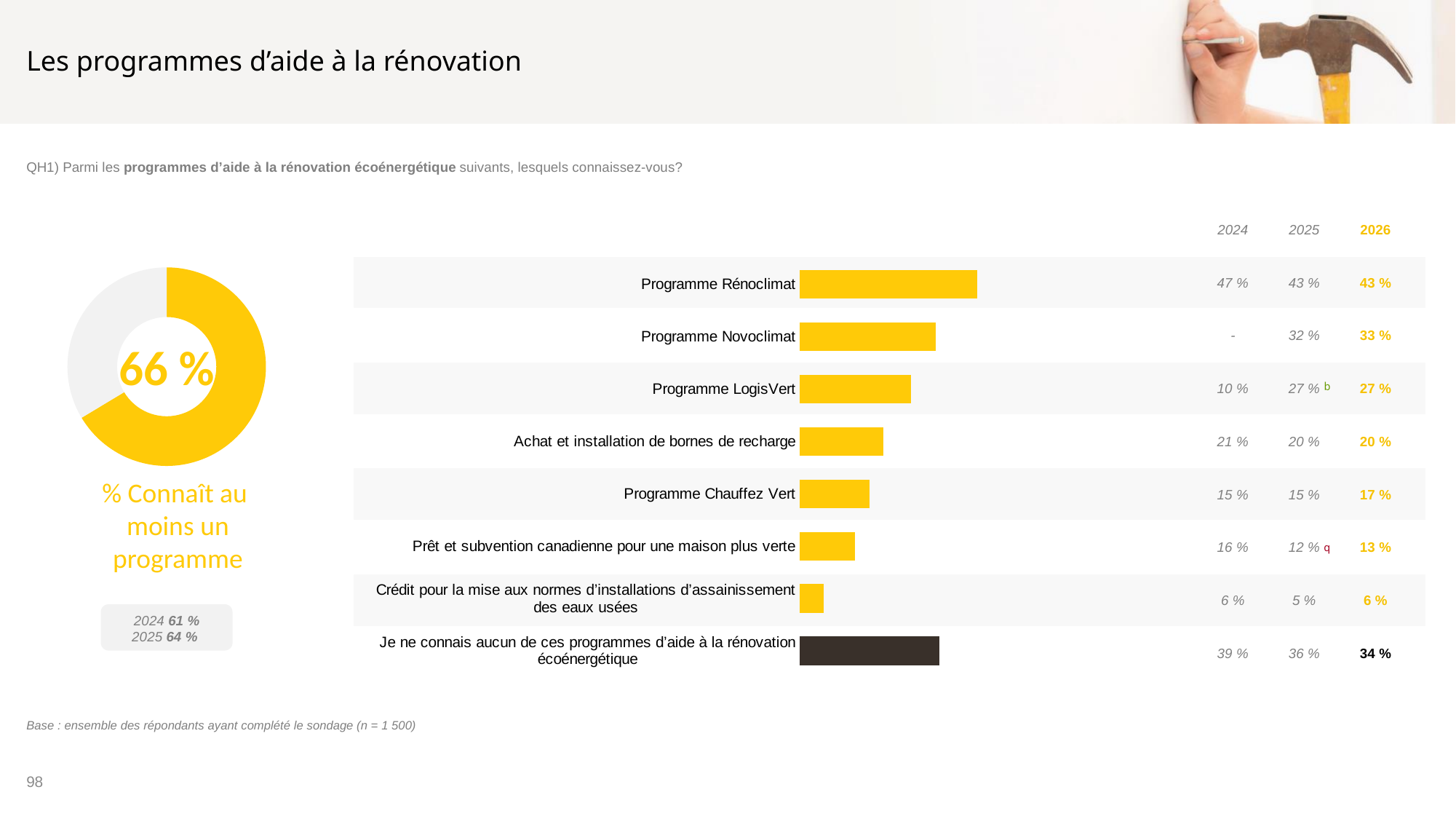
In the bar chart, which has a larger 2026 value: Programme Chauffez Vert or Achat et installation de bornes de recharge? Achat et installation de bornes de recharge How many categories are shown in the bar chart? 8 In the bar chart, what is the 2026 value for Programme Novoclimat? 33 % In the bar chart, which bar is shown in a dark colour rather than yellow? Je ne connais aucun de ces programmes d'aide à la rénovation écoénergétique In the bar chart, what is the 2024 value for Programme LogisVert? 10 % In the bar chart, which programme has the highest 2026 value? Programme Rénoclimat What kind of chart is the chart on the right of the slide? bar chart In the bar chart, what is the 2026 value for the category 'Je ne connais aucun de ces programmes d'aide à la rénovation écoénergétique'? 34 % In the bar chart, what is the difference between the 2026 values for Programme Rénoclimat and Programme Novoclimat? 10 % In the bar chart, which category has the lowest 2026 value? Crédit pour la mise aux normes d'installations d'assainissement des eaux usées In the bar chart, what is the 2026 value for Programme Rénoclimat? 43 % In the donut chart on the left, what percentage of respondents know at least one programme? 66 %